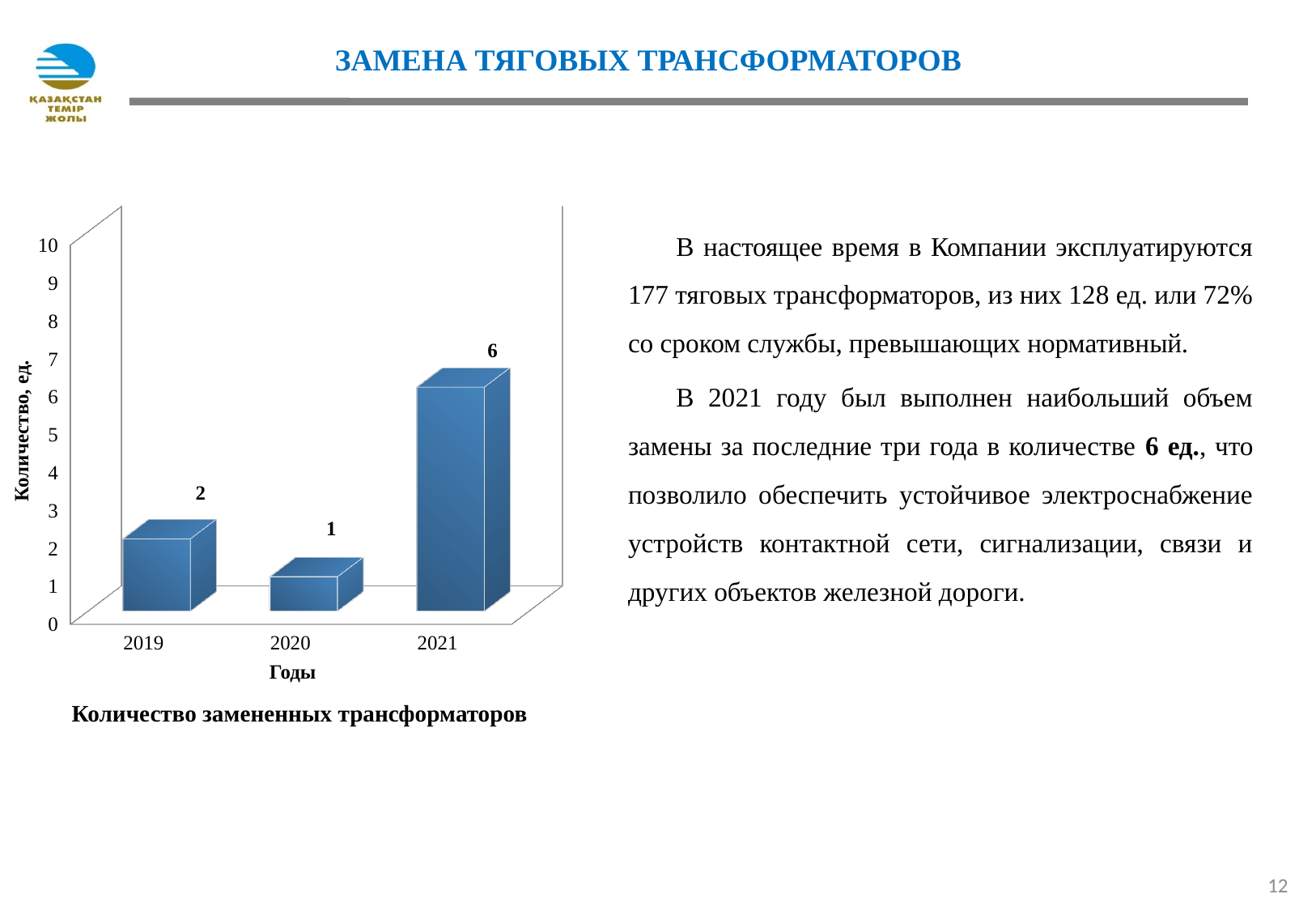
What is the value for 2020? 1 What is the difference between the values for 2021 and 2019? 4 How many years are shown on the x axis? 3 Is the value for 2021 greater or less than 5? greater What kind of chart is shown on the slide? bar chart What is the value for 2019? 2 Which year has the lowest value? 2020 What is the caption below the chart? Количество замененных трансформаторов Which year has the highest value? 2021 What is the value for 2021? 6 What is the label of the y axis? Количество, ед. Which is larger, the value for 2019 or the value for 2020? 2019